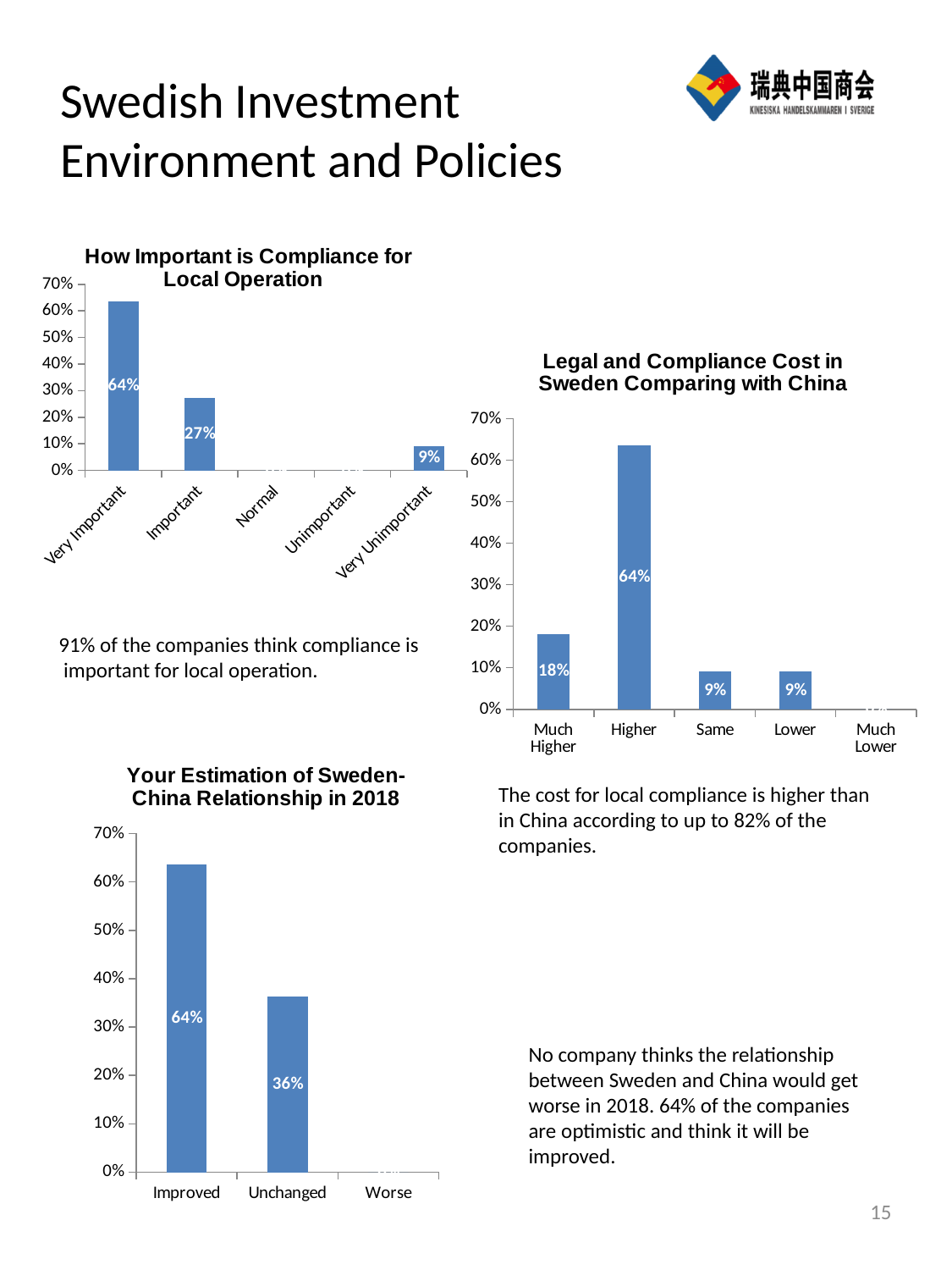
In the chart 'Legal and Compliance Cost in Sweden Comparing with China', is the value for Higher greater or less than 60%? greater In the chart 'Legal and Compliance Cost in Sweden Comparing with China', what is the value for Much Higher? 18% In the chart 'Legal and Compliance Cost in Sweden Comparing with China', what is the difference between Higher and Much Higher? 46% What kind of chart is 'Your Estimation of Sweden-China Relationship in 2018'? bar chart In the chart 'Your Estimation of Sweden-China Relationship in 2018', what is the value for Unchanged? 36% How many categories are shown on the x axis of the chart 'How Important is Compliance for Local Operation'? 5 In the chart 'Your Estimation of Sweden-China Relationship in 2018', which is larger, Improved or Unchanged? Improved In the chart 'How Important is Compliance for Local Operation', what is the value for Important? 27% In the chart 'How Important is Compliance for Local Operation', what is the value for Very Important? 64% In the chart 'Legal and Compliance Cost in Sweden Comparing with China', which category has the highest value? Higher In the chart 'How Important is Compliance for Local Operation', which category has the highest value? Very Important In the chart 'How Important is Compliance for Local Operation', what is the difference between Very Important and Important? 37%